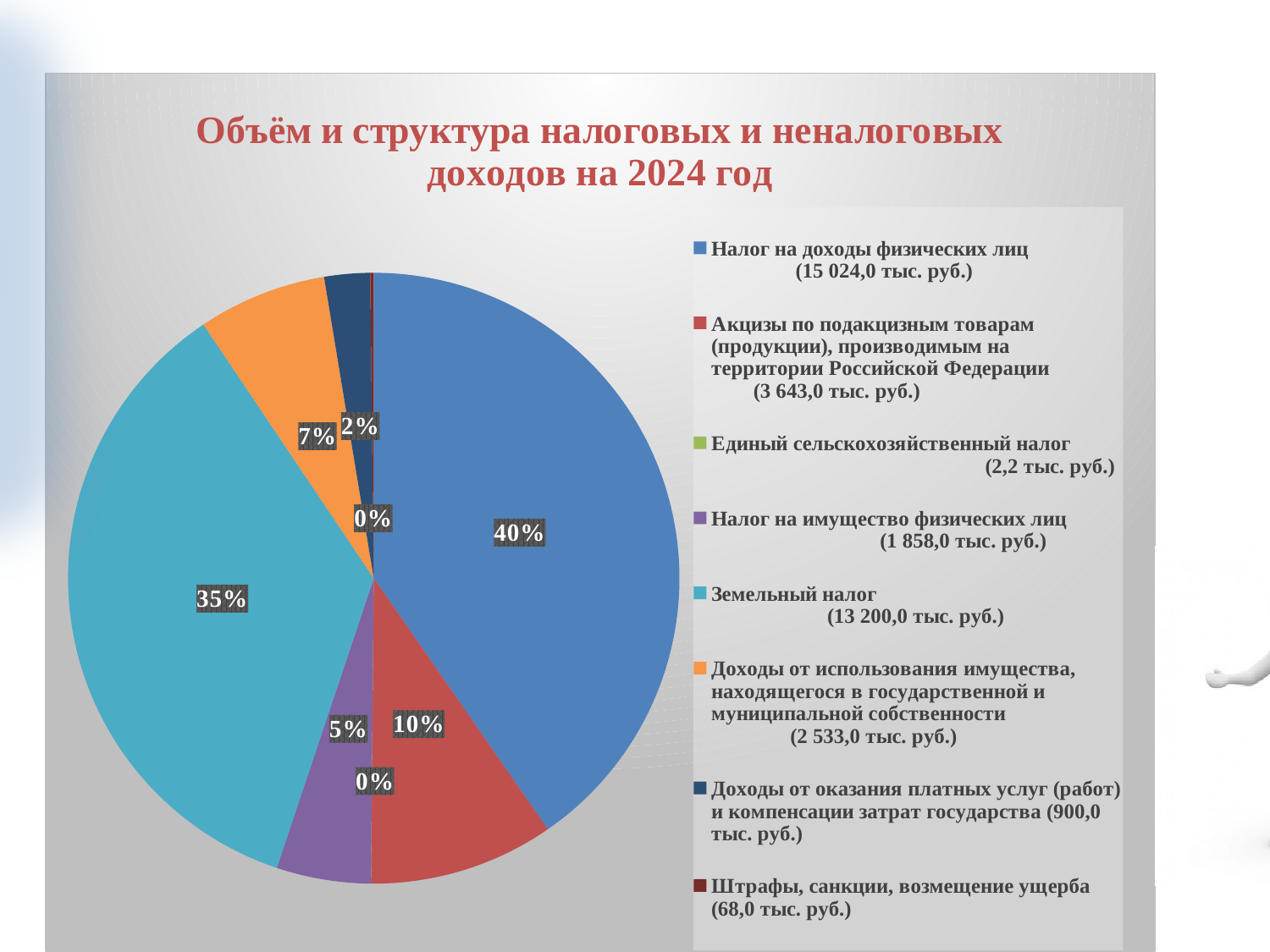
What amount is given in the legend for "Земельный налог"? 13 200,0 тыс. руб. Which slice is larger: "Налог на имущество физических лиц" or "Доходы от использования имущества, находящегося в государственной и муниципальной собственности"? Доходы от использования имущества, находящегося в государственной и муниципальной собственности Which category has the largest slice of the pie? Налог на доходы физических лиц What share of the pie does "Земельный налог" take? 35% What amount is given in the legend for "Штрафы, санкции, возмещение ущерба"? 68,0 тыс. руб. What is the difference in percentage points between the "Налог на доходы физических лиц" slice and the "Земельный налог" slice? 5% What share of the pie does "Налог на доходы физических лиц" take? 40% What share of the pie does "Доходы от использования имущества, находящегося в государственной и муниципальной собственности" take? 7% How many categories does the legend list? 8 What kind of chart is shown on the slide? pie chart